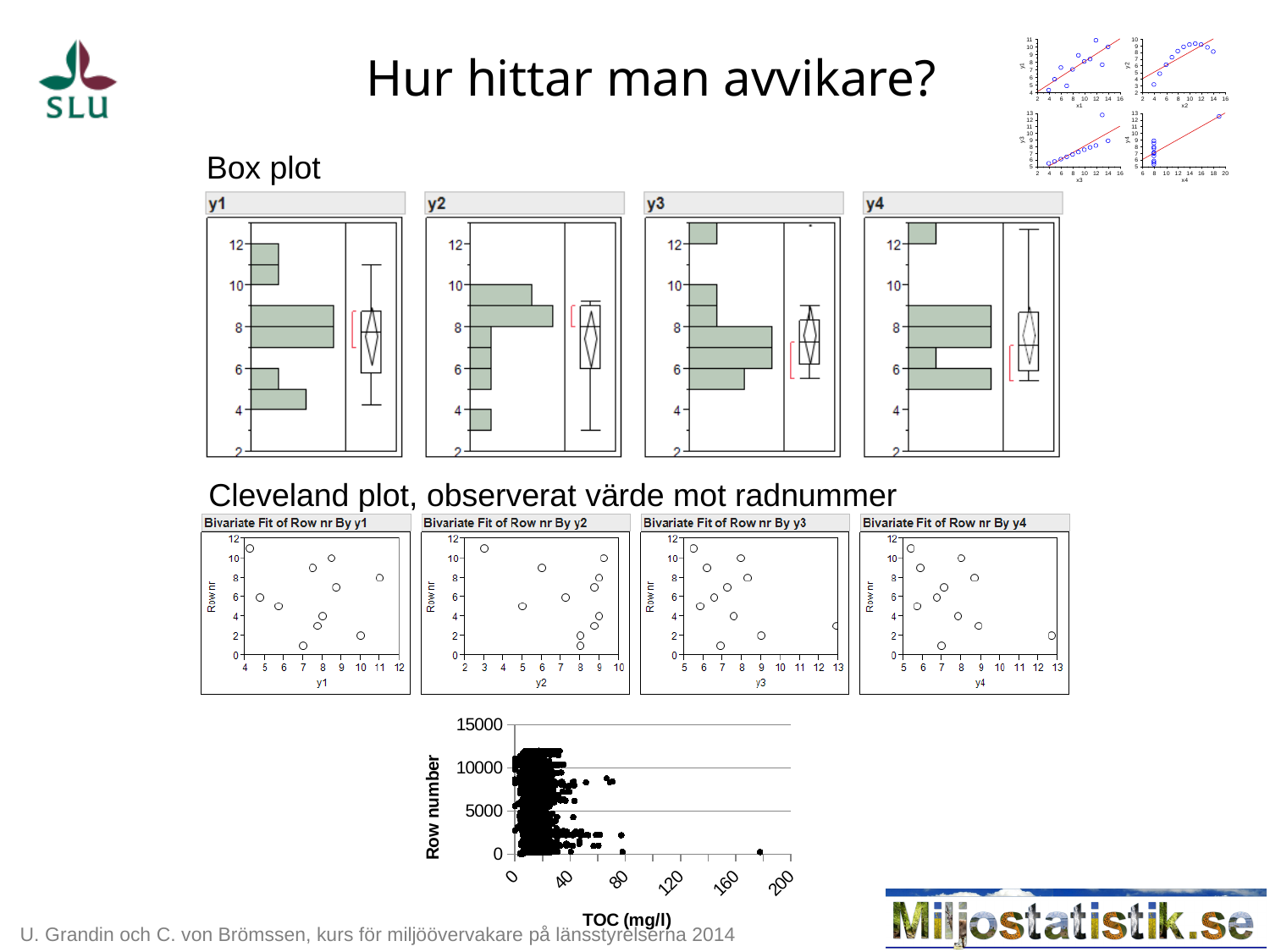
In the 'Bivariate Fit of Row nr By y2' chart, is the y2 value of the point at row 11 greater or less than 4? less How many box plots are shown in the 'Box plot' row of the slide? 4 In the bottom chart, what is the label of the x axis? TOC (mg/l) In the bottom chart, what is the label of the y axis? Row number In the 'Bivariate Fit of Row nr By y4' chart, is the y4 value of the point at row 2 greater or less than 12? greater In the 'Bivariate Fit of Row nr By y3' chart, is the y3 value of the point at row 3 greater or less than 12? greater What kind of chart is the bottom chart with axes 'Row number' and 'TOC (mg/l)'? scatter plot In the y1 box plot panel, which value on the vertical axis has the longest histogram bar? 8 How many 'Bivariate Fit of Row nr' charts are shown in the Cleveland plot row? 4